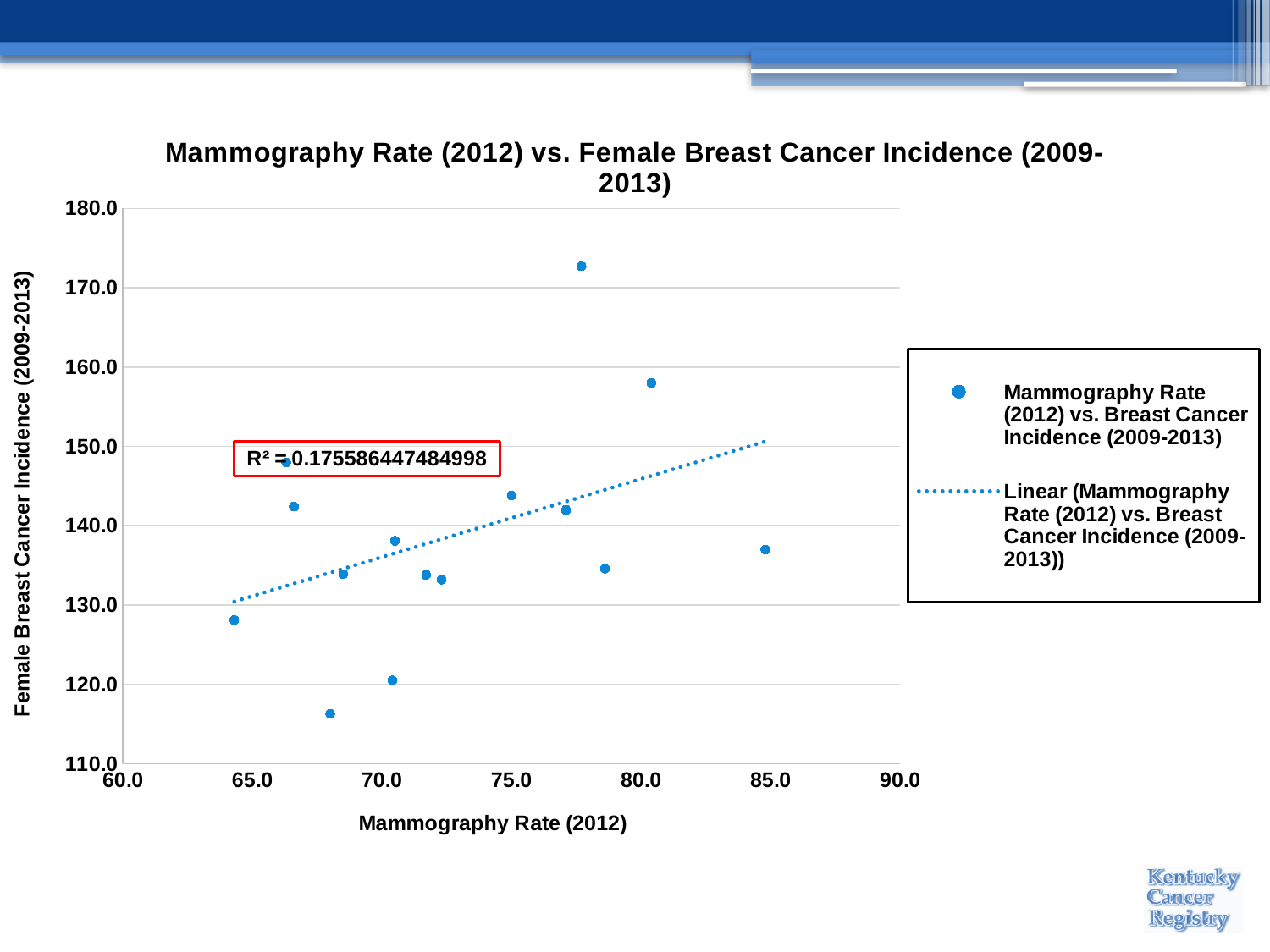
Is the mammography rate of the rightmost plotted point greater or less than 80.0? greater What is the label of the x axis? Mammography Rate (2012) Is the breast cancer incidence of the lowest plotted point greater or less than 120.0? less Is the mammography rate of the leftmost plotted point greater or less than 65.0? less What kind of chart is shown on the slide? Scatter chart What is the title of the chart? Mammography Rate (2012) vs. Female Breast Cancer Incidence (2009-2013) Does the dotted linear trendline rise or fall as the mammography rate increases? Rises How many entries does the legend list? 2 What R² value is printed on the chart? 0.175586447484998 How many data points are plotted on the chart? 15 What is the highest value shown on the y axis? 180.0